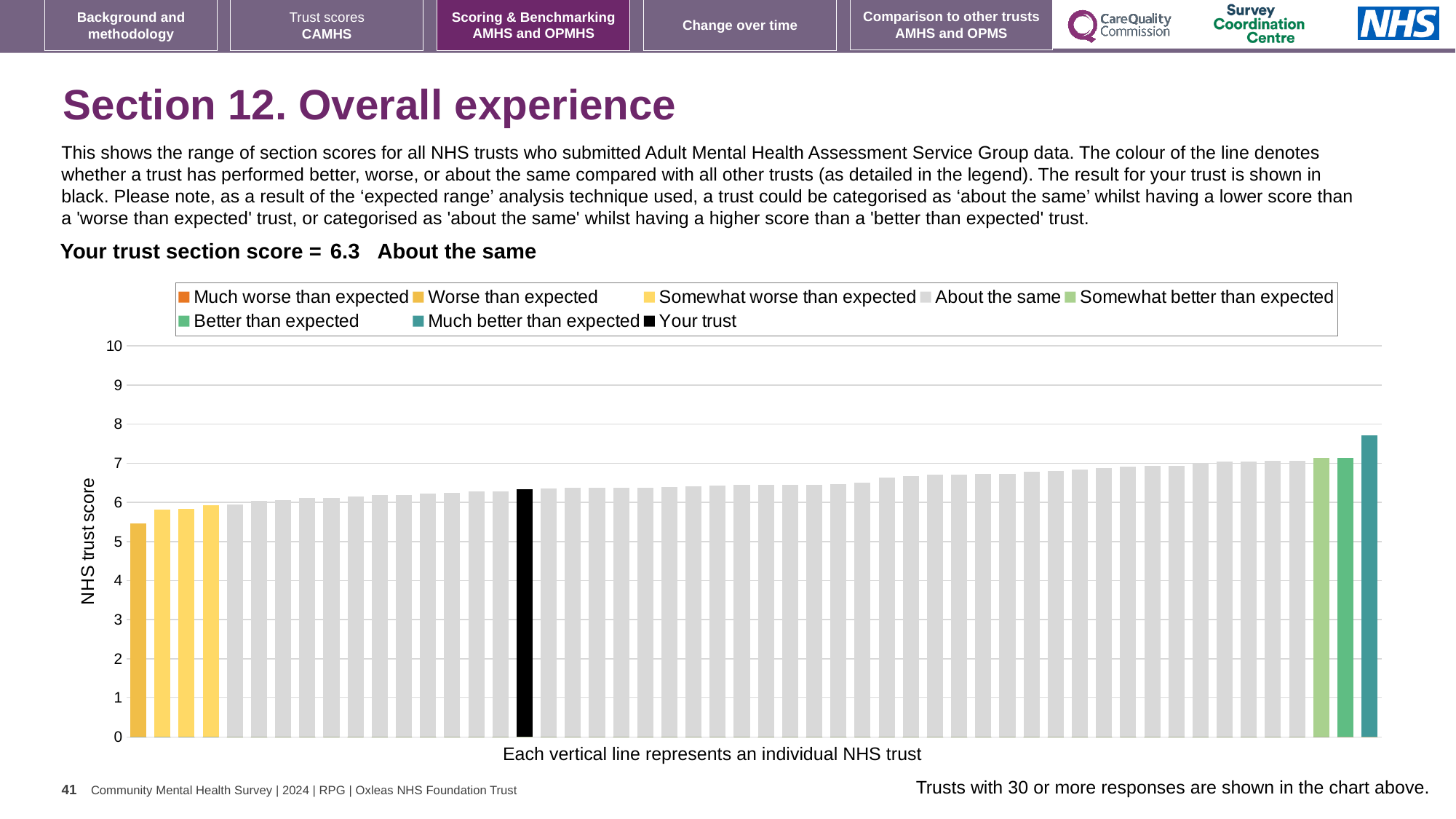
Is the value of the shortest bar in the chart greater or less than 5? greater Is the value of the shortest bar in the chart greater or less than 6? less What kind of chart is shown on the slide? bar chart Do the bar values rise or fall from left to right across the chart? rise Is the value of the tallest bar in the chart greater or less than 8? less How many entries does the chart legend list? 8 According to the chart, what does each vertical line represent? an individual NHS trust What is the section score for your trust shown on the slide? 6.3 What is the label on the vertical axis of the chart? NHS trust score Which category is your trust's section score placed in? About the same